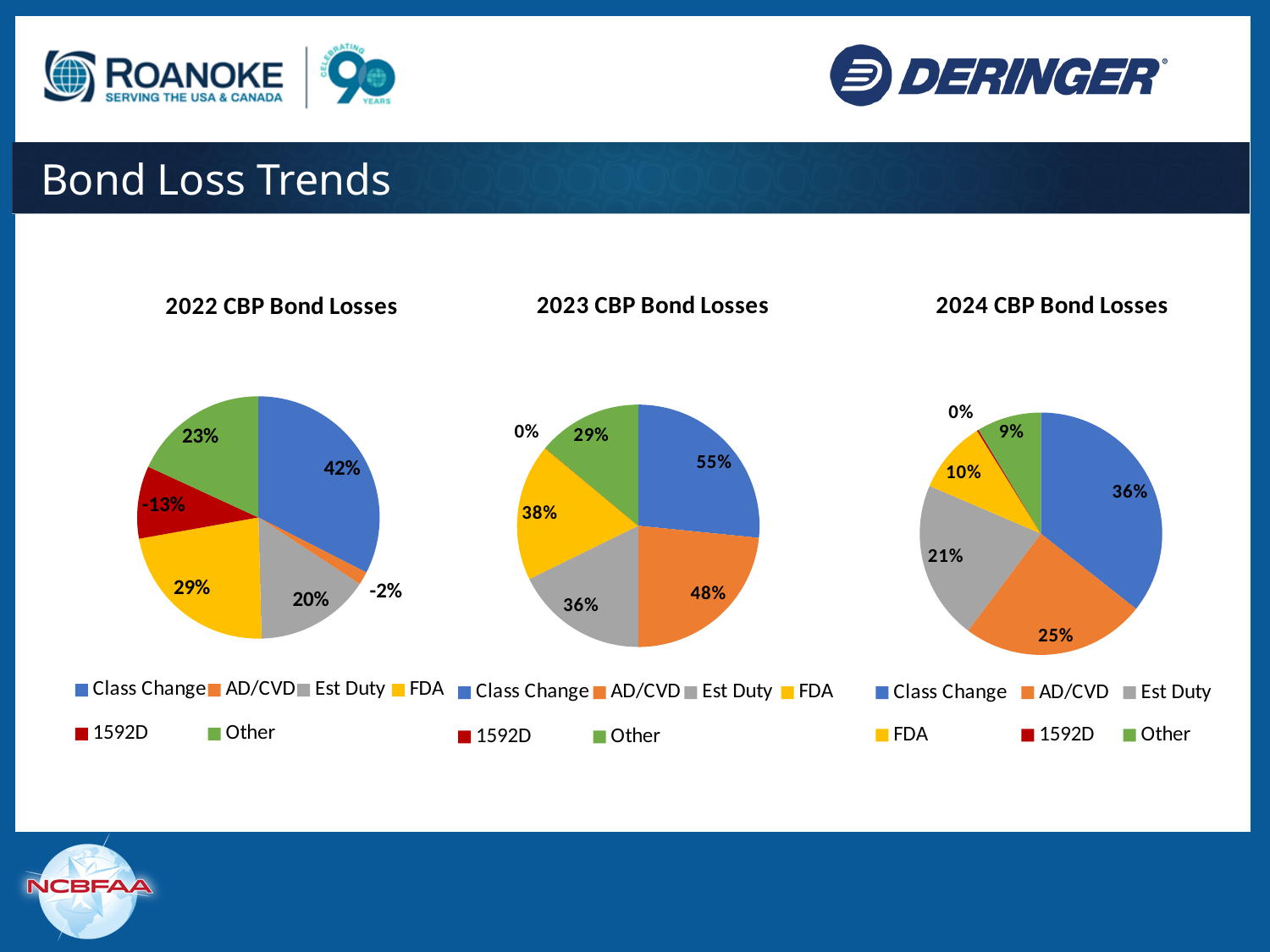
In the 2023 CBP Bond Losses chart, what percentage is shown for AD/CVD? 48% In the 2022 CBP Bond Losses chart, what percentage is shown for 1592D? -13% In the 2022 CBP Bond Losses chart, what percentage is shown for Class Change? 42% In the 2023 CBP Bond Losses chart, what is the difference between the Class Change and Other percentages? 26% In the 2024 CBP Bond Losses chart, which is larger, FDA or Other? FDA What kind of chart is the 2023 CBP Bond Losses chart? Pie chart How many categories does the legend of the 2024 CBP Bond Losses chart list? 6 In the 2024 CBP Bond Losses chart, which category has the largest share? Class Change In the 2023 CBP Bond Losses chart, which is larger, FDA or Est Duty? FDA In the 2024 CBP Bond Losses chart, what percentage is shown for Est Duty? 21% In the 2022 CBP Bond Losses chart, which category has the lowest value? 1592D What is the title of the leftmost chart on the slide? 2022 CBP Bond Losses